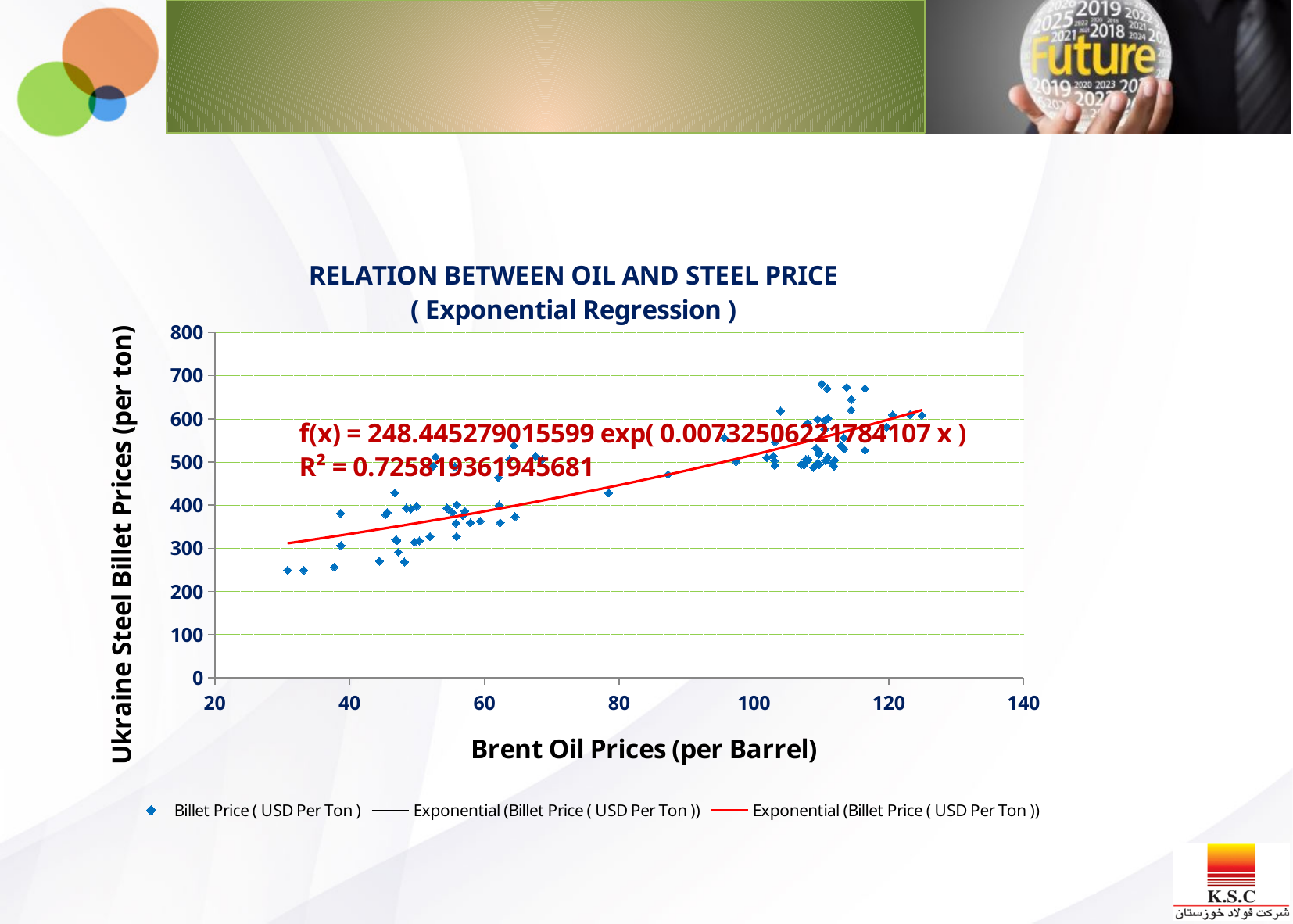
What is the title of the chart? RELATION BETWEEN OIL AND STEEL PRICE ( Exponential Regression ) Is the highest billet price plotted on the chart greater or less than 600? greater What is the label of the x axis? Brent Oil Prices (per Barrel) How many entries does the chart legend list? 3 Is the billet price at a Brent oil price of about 88 per barrel greater or less than 400? greater What kind of chart is shown on the slide? Scatter chart As Brent oil prices increase along the x axis, do Ukraine steel billet prices generally rise or fall? Rise Is the lowest billet price plotted on the chart greater or less than 300? less What is the R² value printed on the chart? 0.725819361945681 What is the regression equation printed on the chart? f(x) = 248.445279015599 exp( 0.00732506221784107 x ) What is the minimum value shown on the x axis? 20 What is the maximum value shown on the y axis? 800